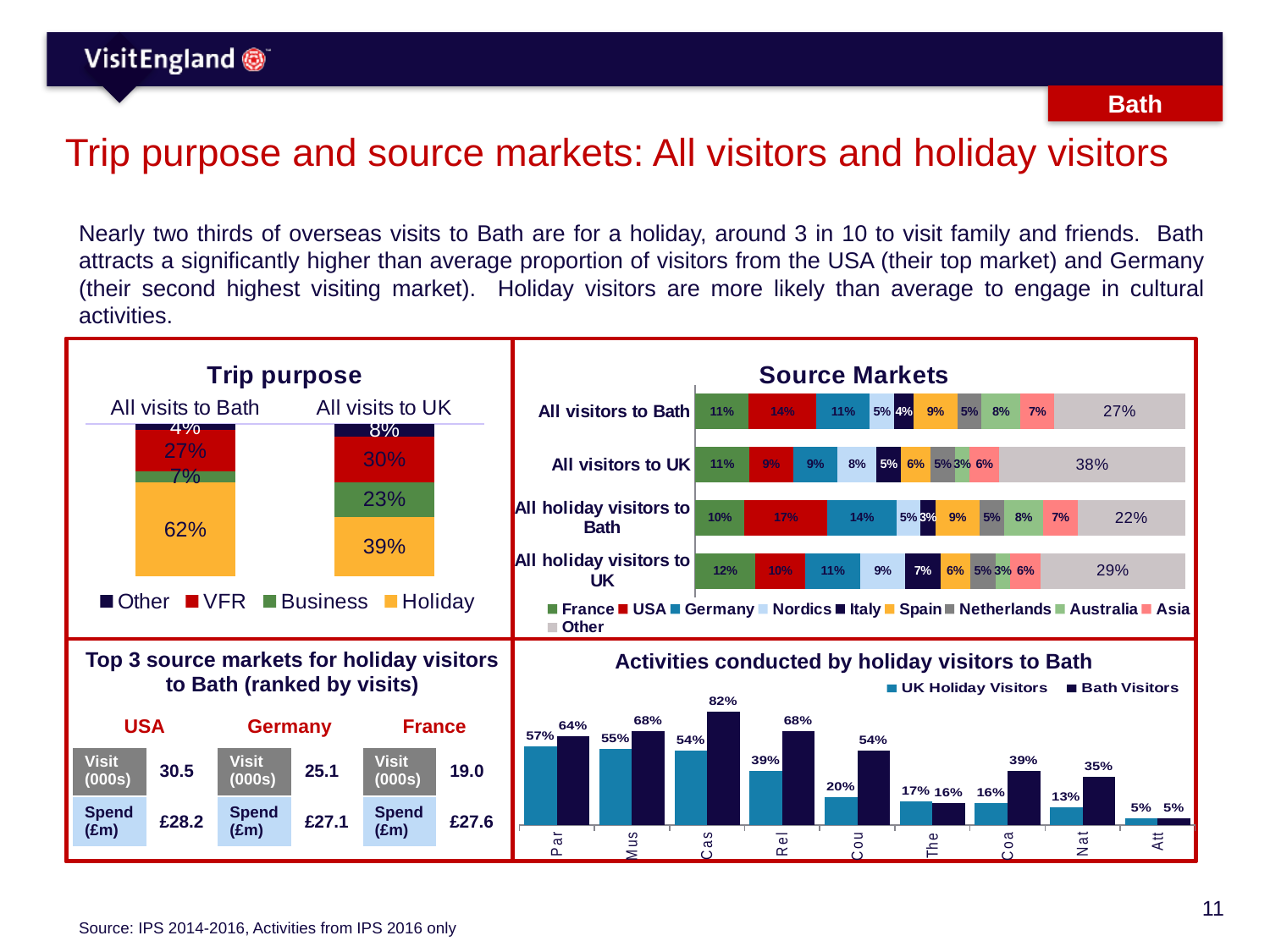
How many series does the legend of the Trip purpose chart list? 4 In the Source Markets chart, what share of all visitors to Bath come from the USA? 14% In the Source Markets chart, which is larger: the USA share of all holiday visitors to Bath or the USA share of all holiday visitors to the UK? All holiday visitors to Bath How many series does the legend of the Source Markets chart list? 10 In the Activities conducted by holiday visitors to Bath chart, what is the highest value shown for Bath Visitors? 82% How many categories (bars) are shown in the Source Markets chart? 4 In the Source Markets chart, what is the 'Other' share for all visitors to the UK? 38% In the Trip purpose chart, what is the difference between the Business share for all visits to the UK and for all visits to Bath? 16 percentage points What type of chart is the Source Markets chart? Stacked bar chart How many activity categories are shown in the Activities conducted by holiday visitors to Bath chart? 9 In the Trip purpose chart, what share of all visits to Bath are for a holiday? 62% In the Trip purpose chart, what is the VFR share for all visits to the UK? 30%